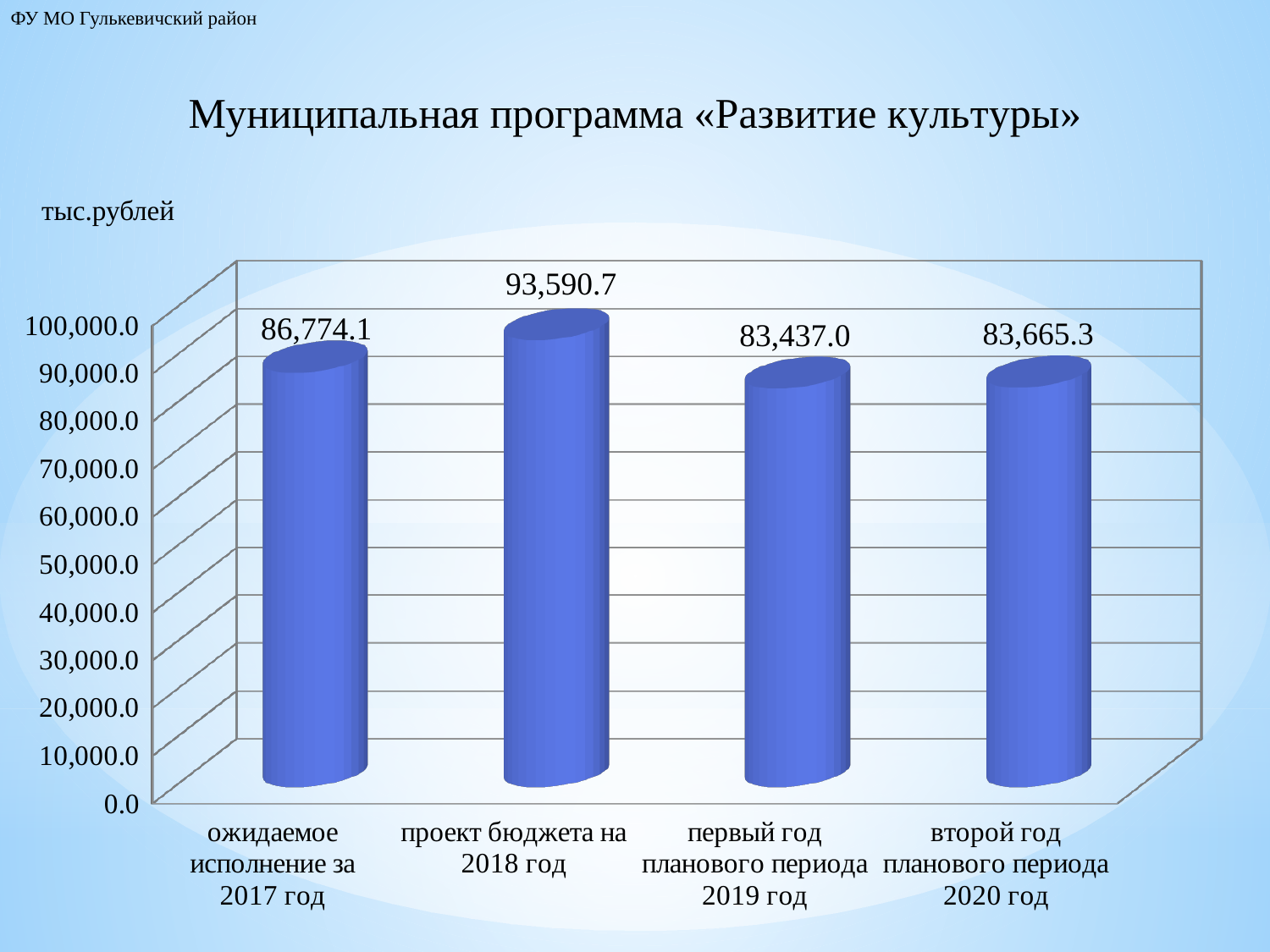
Which category has the lowest value? первый год планового периода 2019 год What is the value for «проект бюджета на 2018 год»? 93,590.7 What is the value for «второй год планового периода 2020 год»? 83,665.3 What kind of chart is shown on the slide? bar chart Is the value for «проект бюджета на 2018 год» greater or less than 90,000.0? greater How many categories are shown on the chart? 4 What is the difference between the value for 2020 and the value for 2019? 228.3 What is the value for «ожидаемое исполнение за 2017 год»? 86,774.1 What is the difference between the value for 2018 and the value for 2017? 6,816.6 What is the value for «первый год планового периода 2019 год»? 83,437.0 Which category has the highest value? проект бюджета на 2018 год Which is larger, the value for 2017 or the value for 2019? 2017